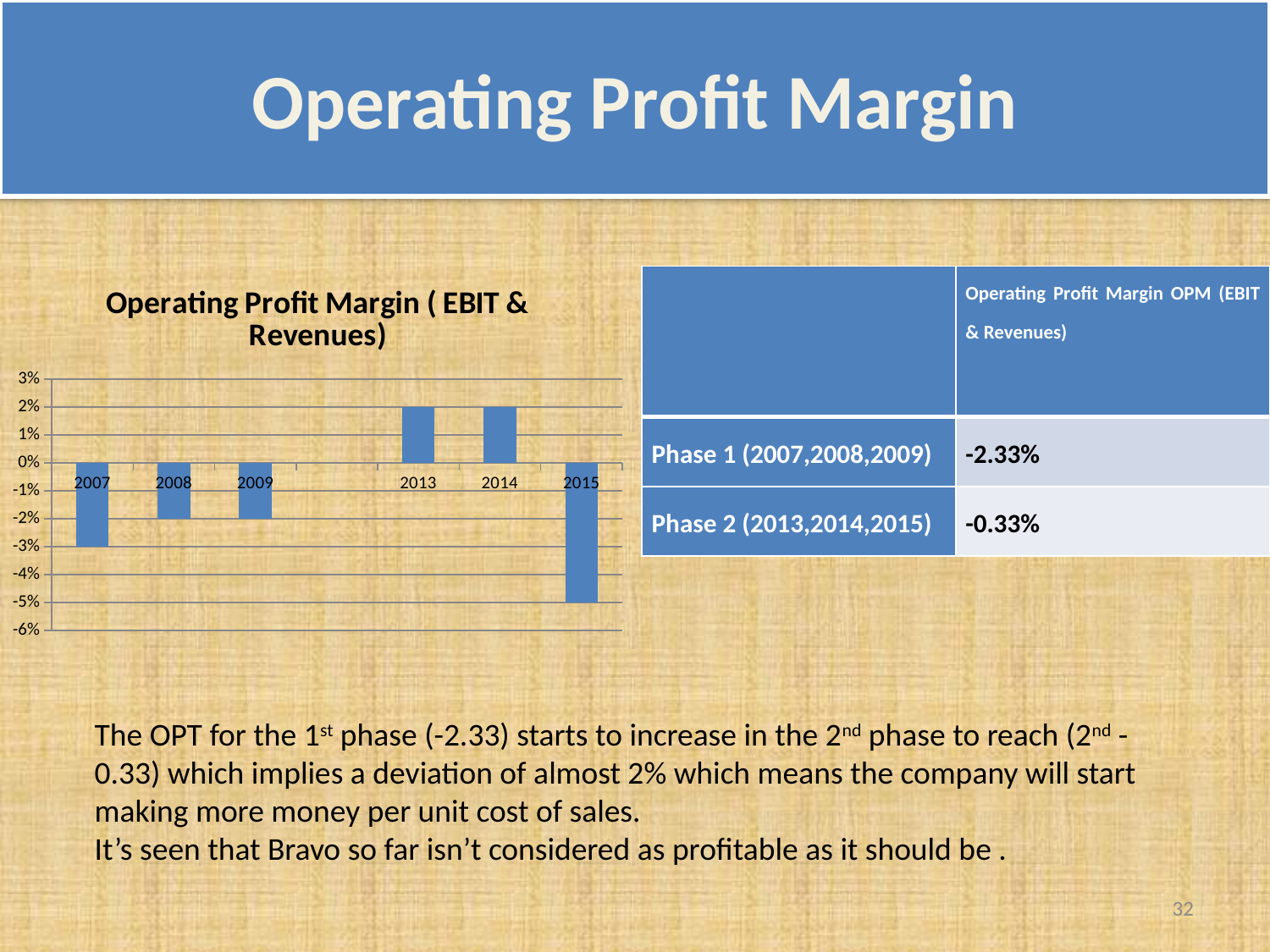
Is the value for 2014 greater or less than 0%? greater What kind of chart is shown on the slide? bar chart How many years are plotted on the chart? 6 Is the value for 2008 greater or less than -1%? less Is the value for 2013 greater or less than 1%? greater Which year has the higher operating profit margin, 2009 or 2013? 2013 Which year has the lower operating profit margin, 2007 or 2015? 2015 Which year has the lowest operating profit margin? 2015 Which year has the higher operating profit margin, 2007 or 2008? 2008 What is the title of the chart? Operating Profit Margin ( EBIT & Revenues)